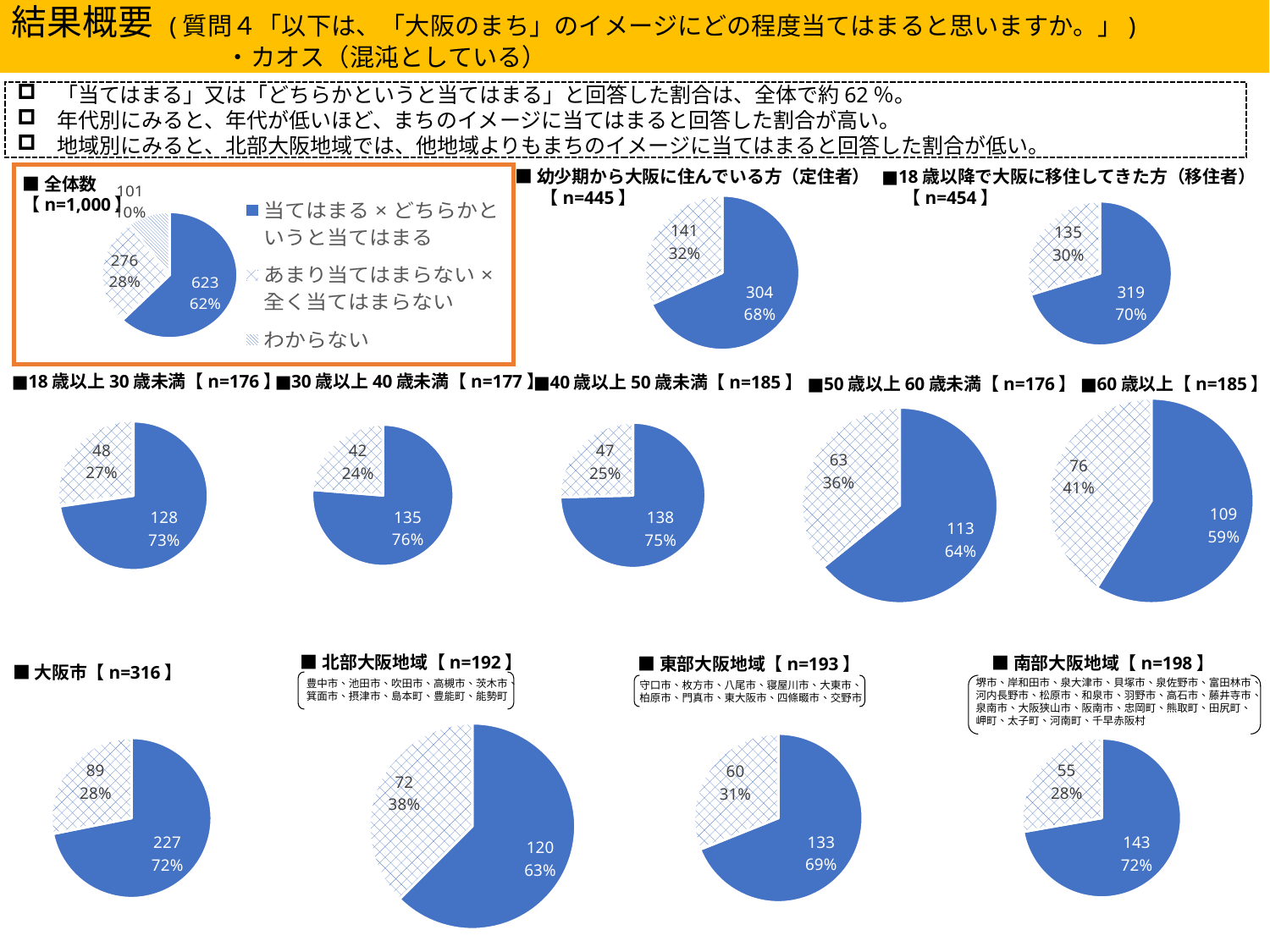
Among the five age-group pie charts, which has the lowest percentage for 当てはまる × どちらかというと当てはまる? 60歳以上【n=185】 In the 18歳以降で大阪に移住してきた方（移住者）【n=454】 pie chart, what is the count for the 当てはまる × どちらかというと当てはまる slice? 319 In the 東部大阪地域【n=193】 pie chart, how many respondents are in the あまり当てはまらない × 全く当てはまらない slice? 60 Which has a larger 当てはまる × どちらかというと当てはまる percentage: the 大阪市【n=316】 pie chart or the 北部大阪地域【n=192】 pie chart? 大阪市【n=316】 In the 南部大阪地域【n=198】 pie chart, what percentage is shown for the 当てはまる × どちらかというと当てはまる slice? 72% What kind of chart is used for the 幼少期から大阪に住んでいる方（定住者）【n=445】 data? Pie chart Among the five age-group pie charts (18歳以上30歳未満 through 60歳以上), which has the highest percentage for 当てはまる × どちらかというと当てはまる? 30歳以上40歳未満【n=177】 What is the difference in count between the two slices of the 60歳以上【n=185】 pie chart? 33 In the 全体数【n=1,000】 pie chart, what percentage is shown for 当てはまる × どちらかというと当てはまる? 62% How many entries does the legend next to the 全体数 pie chart list? 3 In the 幼少期から大阪に住んでいる方（定住者）【n=445】 pie chart, what share of the pie is the あまり当てはまらない × 全く当てはまらない slice? 32% In the 全体数【n=1,000】 pie chart, how many respondents answered わからない? 101